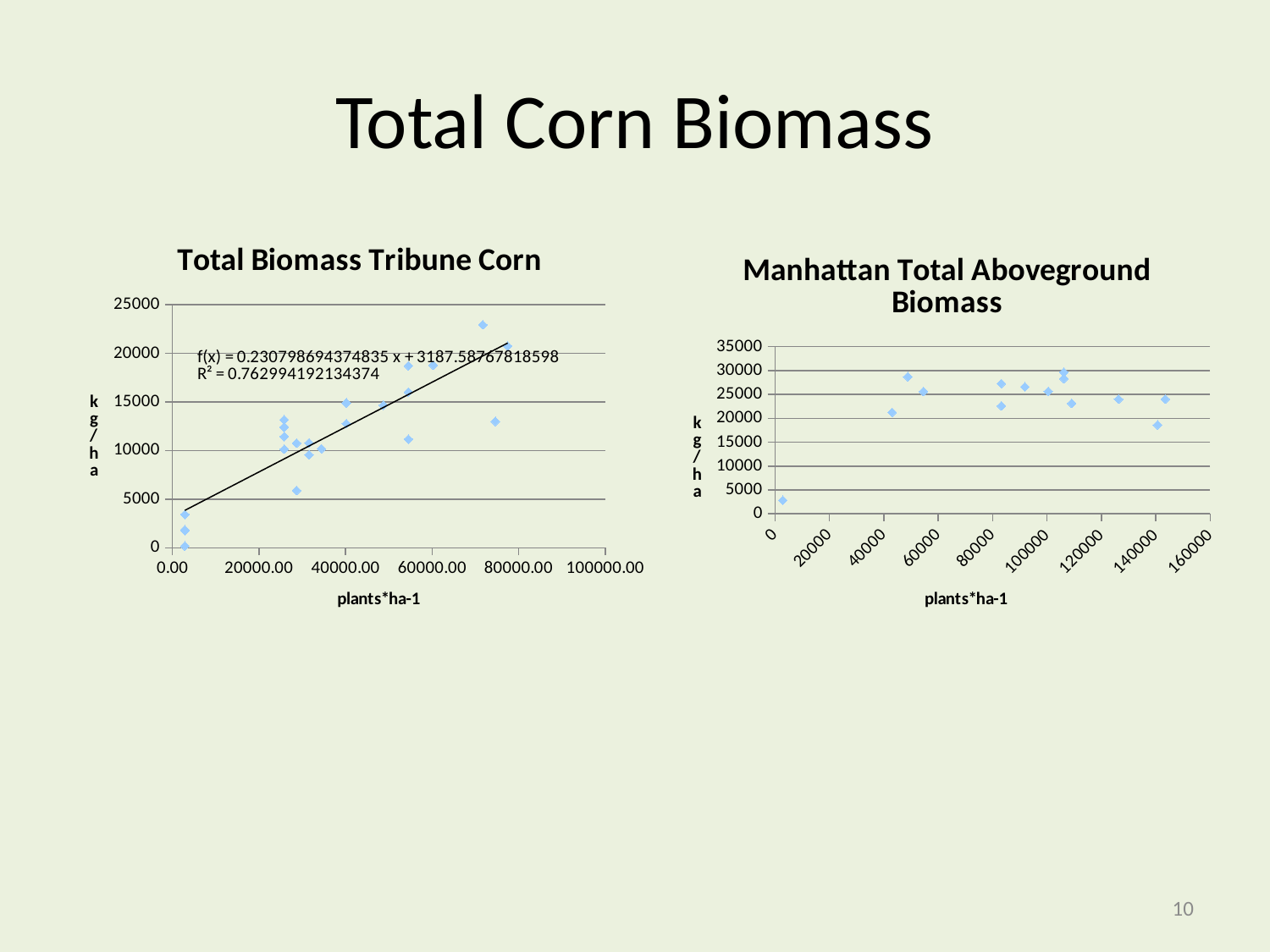
In the 'Manhattan Total Aboveground Biomass' chart, is the point plotted near 50000 plants*ha-1 greater or less than 25000 kg/ha? greater What kind of chart is the 'Manhattan Total Aboveground Biomass' chart? scatter chart What is the title of the chart on the right side of the slide? Manhattan Total Aboveground Biomass In the 'Total Biomass Tribune Corn' chart, is the highest plotted point greater or less than 20000 kg/ha? greater In the 'Total Biomass Tribune Corn' chart, which is higher: the point plotted near 71000 plants*ha-1 or the point plotted near 75000 plants*ha-1? the point near 71000 In the 'Manhattan Total Aboveground Biomass' chart, is the point plotted nearest to 0 plants*ha-1 greater or less than 5000 kg/ha? less In the 'Total Biomass Tribune Corn' chart, what is the slope of the fitted line f(x)? 0.230798694374835 What kind of chart is the 'Total Biomass Tribune Corn' chart? scatter chart In the 'Total Biomass Tribune Corn' chart, does the fitted trendline rise or fall as plants*ha-1 increases? rise In the 'Total Biomass Tribune Corn' chart, what R² value is printed for the trendline? R² = 0.762994192134374 What label is shown on the vertical axis of the 'Total Biomass Tribune Corn' chart? kg/ha